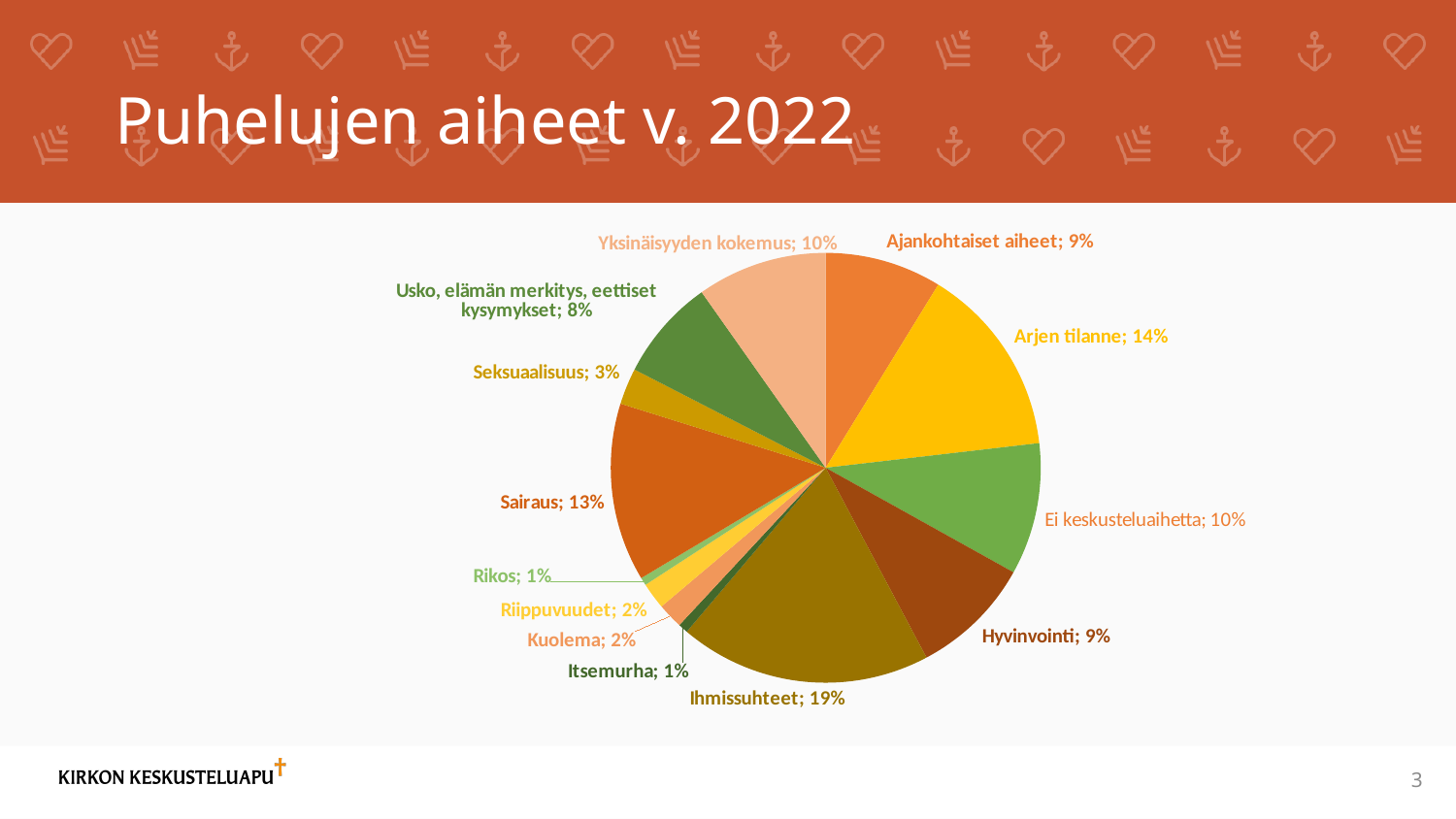
What type of chart is shown on the slide? pie chart What share of the pie does Ei keskusteluaihetta have? 10% What share of the pie does Ihmissuhteet have? 19% Which category has the largest share of the pie? Ihmissuhteet What share of the pie does Seksuaalisuus have? 3% What is the difference in percentage points between Ihmissuhteet and Arjen tilanne? 5 What share of the pie does Usko, elämän merkitys, eettiset kysymykset have? 8% What share of the pie does Sairaus have? 13% How many categories (slices) does the pie chart have? 13 Which has a larger share, Sairaus or Yksinäisyyden kokemus? Sairaus What share of the pie does Arjen tilanne have? 14% What is the title of the slide containing the chart? Puhelujen aiheet v. 2022